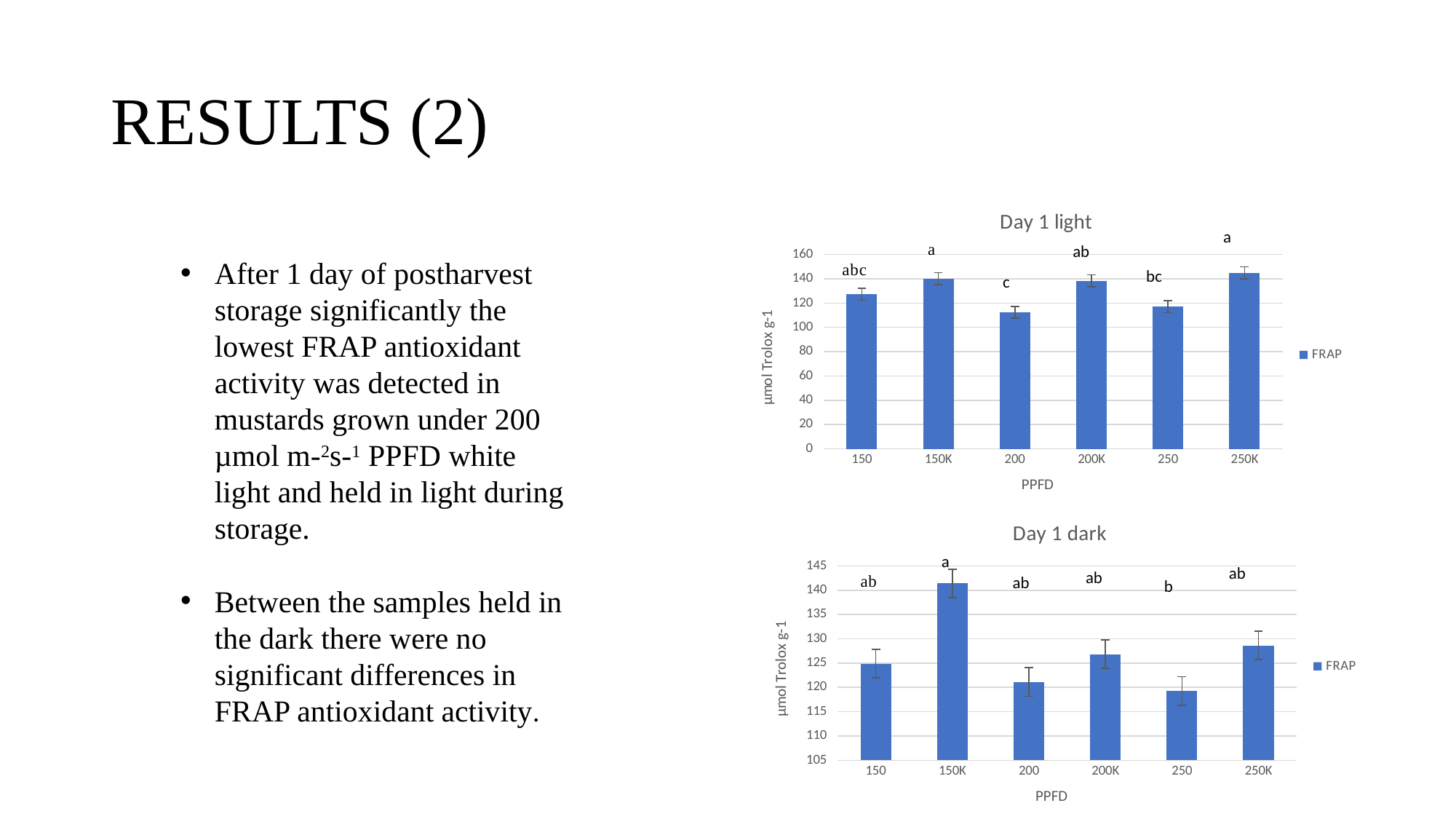
What kind of chart is the Day 1 light chart? bar chart In the Day 1 light chart, is the value for 250K greater or less than 140? greater In the Day 1 dark chart, is the value for 150K greater or less than 140? greater In the Day 1 dark chart, is the value for 150 greater or less than 130? less In the Day 1 dark chart, which is larger, the value for 150K or the value for 250? 150K In the Day 1 light chart, which PPFD category has the lowest FRAP value? 200 In the Day 1 dark chart, which PPFD category has the highest FRAP value? 150K How many series does the legend of the Day 1 dark chart list? 1 In the Day 1 light chart, which is larger, the value for 150K or the value for 200? 150K How many PPFD categories are shown in the Day 1 light chart? 6